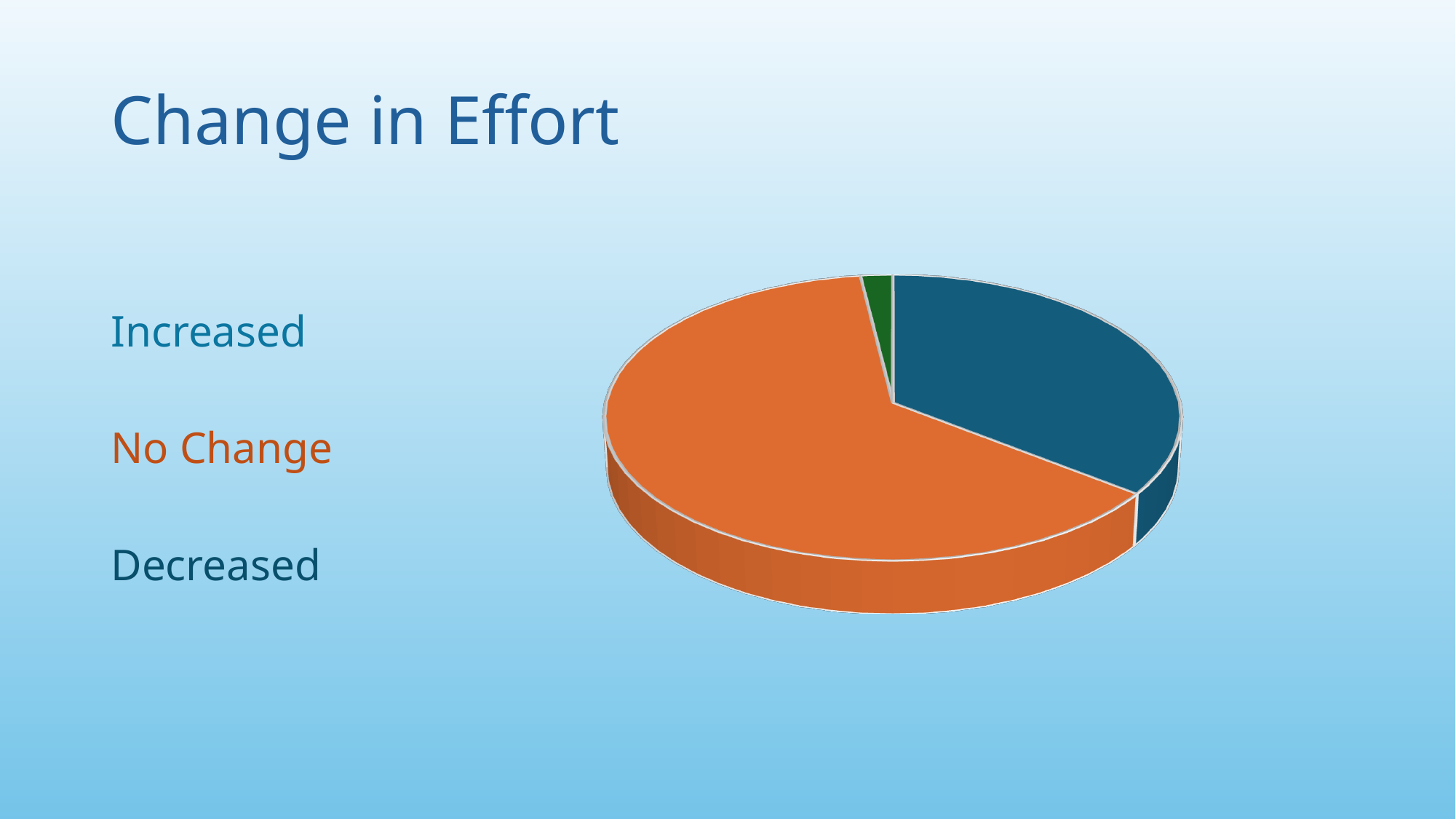
How many slices does the pie chart have? 3 Which slice is larger, No Change or Increased? No Change What is the title of the slide containing the pie chart? Change in Effort Which category has the largest slice of the pie chart? No Change Which slice is larger, No Change or Decreased? No Change Which slice is larger, Increased or Decreased? Increased What colour is the No Change slice of the pie chart? orange Which category has the smallest slice of the pie chart? Decreased What kind of chart is shown on the slide? pie chart